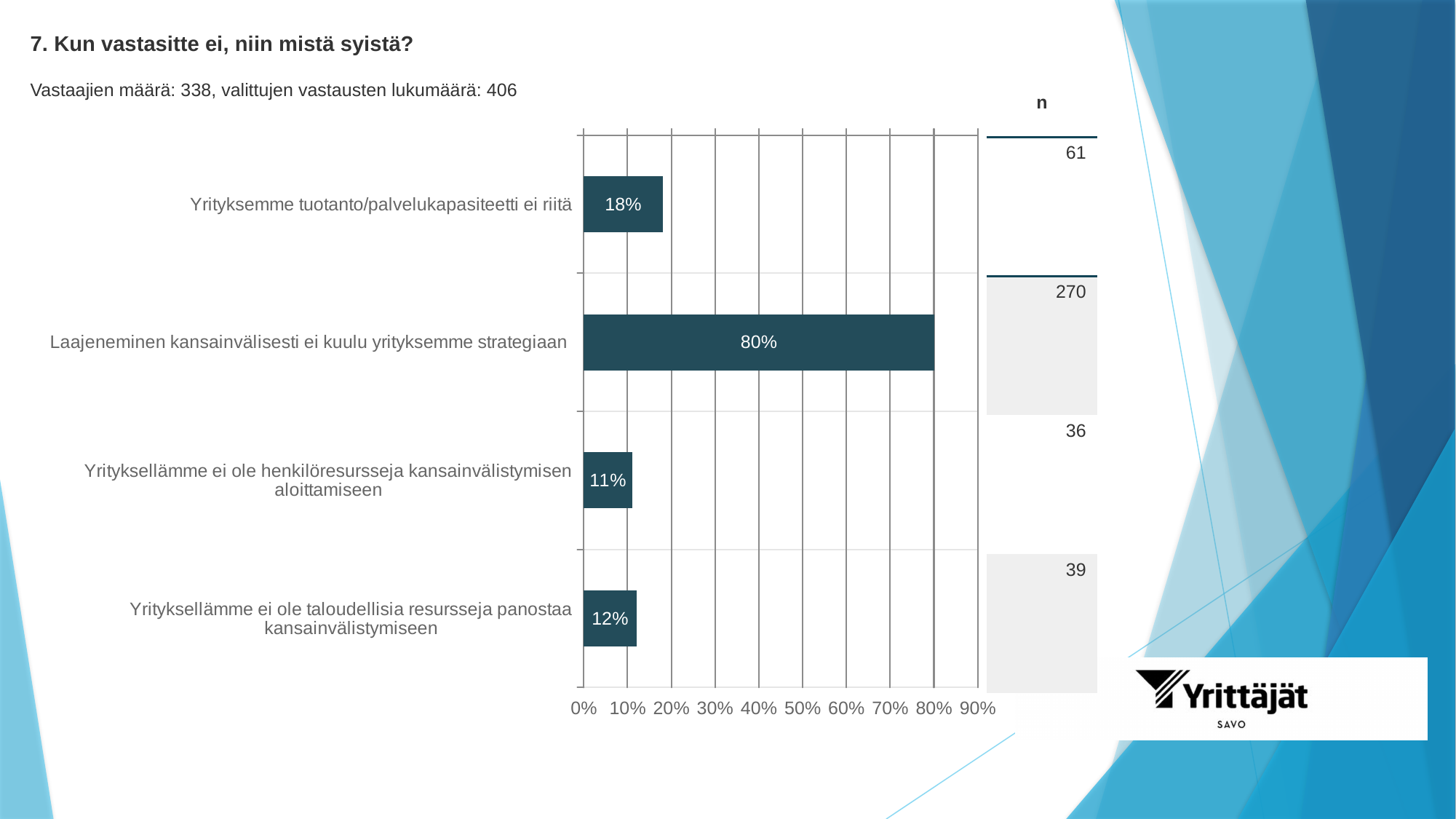
What is the n value for "Yrityksellämme ei ole taloudellisia resursseja panostaa kansainvälistymiseen"? 39 What percentage is shown for "Laajeneminen kansainvälisesti ei kuulu yrityksemme strategiaan"? 80% What is the highest value shown on the x axis? 90% What kind of chart is shown on the slide? Bar chart What is the n value for "Laajeneminen kansainvälisesti ei kuulu yrityksemme strategiaan"? 270 What is the difference in percentage points between "Laajeneminen kansainvälisesti ei kuulu yrityksemme strategiaan" and "Yrityksemme tuotanto/palvelukapasiteetti ei riitä"? 62 percentage points Which has a higher percentage: "Yrityksemme tuotanto/palvelukapasiteetti ei riitä" or "Yrityksellämme ei ole taloudellisia resursseja panostaa kansainvälistymiseen"? Yrityksemme tuotanto/palvelukapasiteetti ei riitä Which category has the lowest percentage? Yrityksellämme ei ole henkilöresursseja kansainvälistymisen aloittamiseen How many categories are shown in the chart? 4 What percentage is shown for "Yrityksellämme ei ole henkilöresursseja kansainvälistymisen aloittamiseen"? 11% Which category has the highest percentage? Laajeneminen kansainvälisesti ei kuulu yrityksemme strategiaan What percentage is shown for "Yrityksemme tuotanto/palvelukapasiteetti ei riitä"? 18%